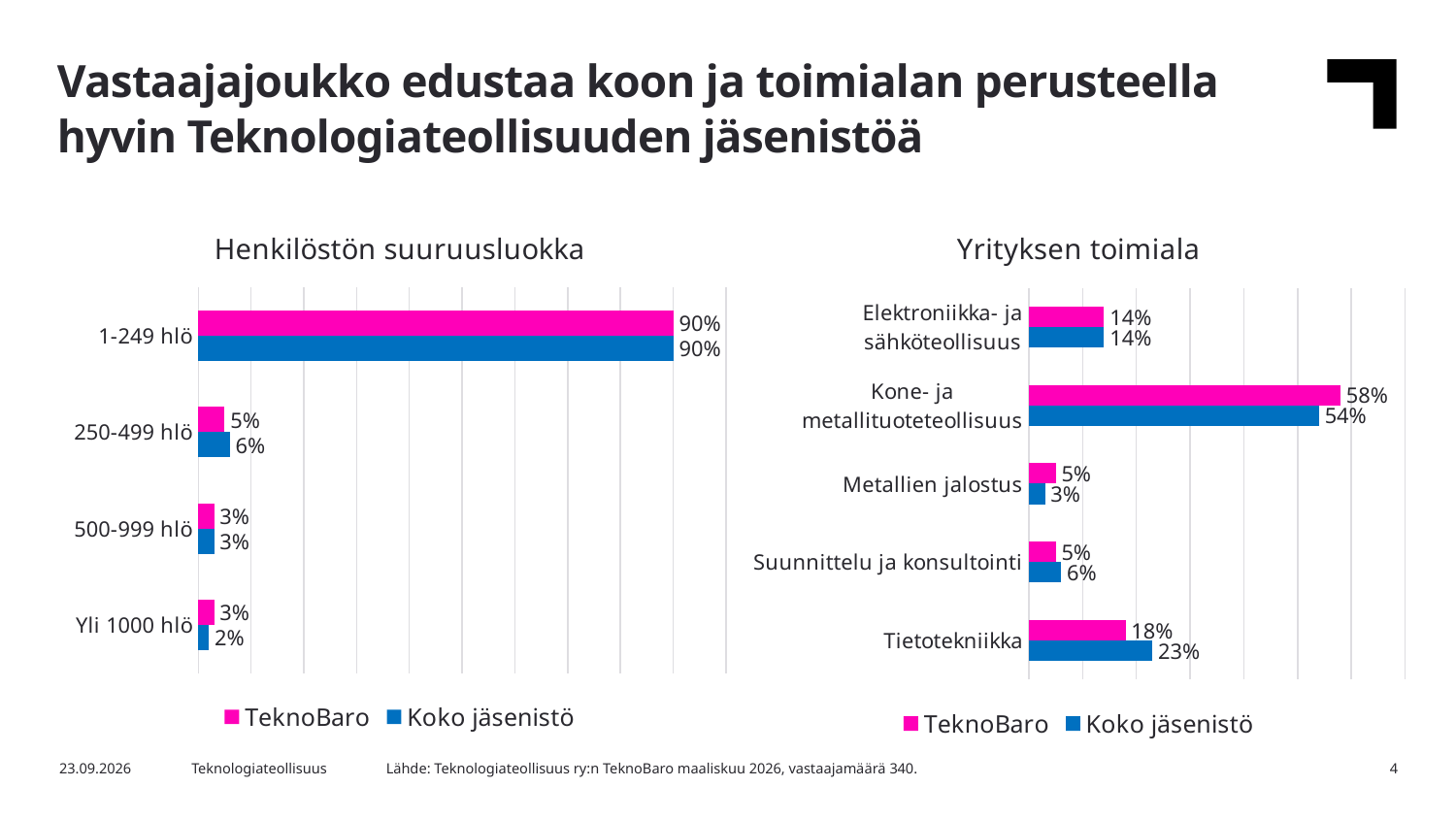
In the 'Yrityksen toimiala' chart, which category has the lowest Koko jäsenistö value? Metallien jalostus In the 'Yrityksen toimiala' chart, what is the difference between the TeknoBaro and Koko jäsenistö values for Kone- ja metallituoteteollisuus? 4% In the 'Henkilöstön suuruusluokka' chart, which category has the highest TeknoBaro value? 1-249 hlö How many series does the legend of the 'Yrityksen toimiala' chart list? 2 What kind of chart is the 'Henkilöstön suuruusluokka' chart? Bar chart In the 'Henkilöstön suuruusluokka' chart, what is the TeknoBaro value for 1-249 hlö? 90% In the 'Henkilöstön suuruusluokka' chart, what is the Koko jäsenistö value for 250-499 hlö? 6% In the 'Henkilöstön suuruusluokka' chart, what is the difference between the TeknoBaro and Koko jäsenistö values for Yli 1000 hlö? 1% In the 'Yrityksen toimiala' chart, what is the Koko jäsenistö value for Tietotekniikka? 23% In the 'Yrityksen toimiala' chart, what is the TeknoBaro value for Kone- ja metallituoteteollisuus? 58% In the 'Henkilöstön suuruusluokka' chart, how many categories are shown? 4 In the 'Yrityksen toimiala' chart, which is larger for Tietotekniikka: the TeknoBaro value or the Koko jäsenistö value? Koko jäsenistö